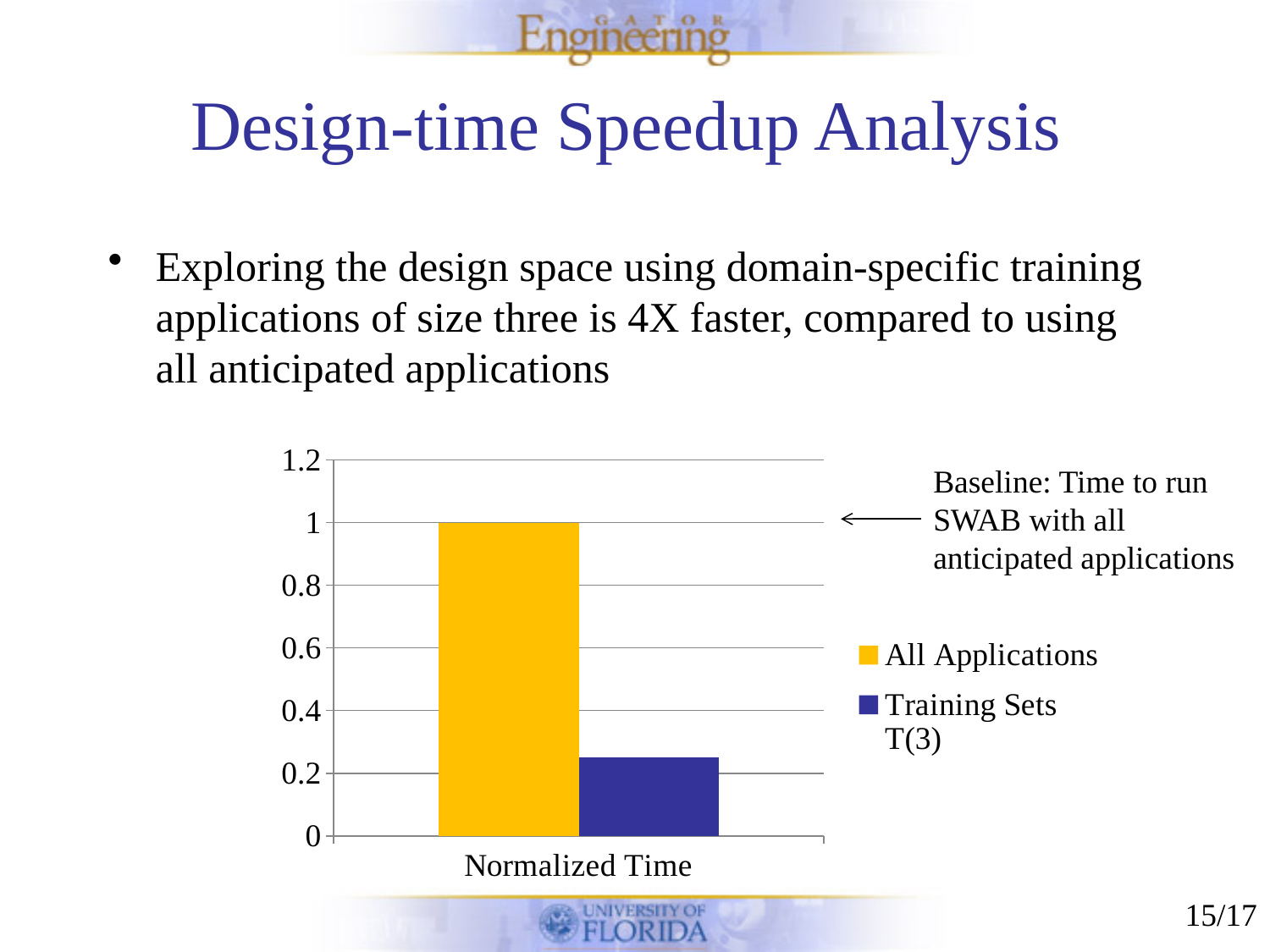
Is the value for All Applications greater or less than 0.8? greater What kind of chart is shown on the slide? bar chart How many series does the legend list? 2 Which series has the highest bar? All Applications What colour is the bar for All Applications? yellow How many categories are shown on the x axis? 1 Is the value for Training Sets T(3) greater or less than 0.4? less Which is larger, the bar for All Applications or the bar for Training Sets T(3)? All Applications Is the value for Training Sets T(3) greater or less than 0.2? greater Which series has the lowest bar? Training Sets T(3) What is the category label shown on the x axis? Normalized Time What is the normalized time value for All Applications? 1